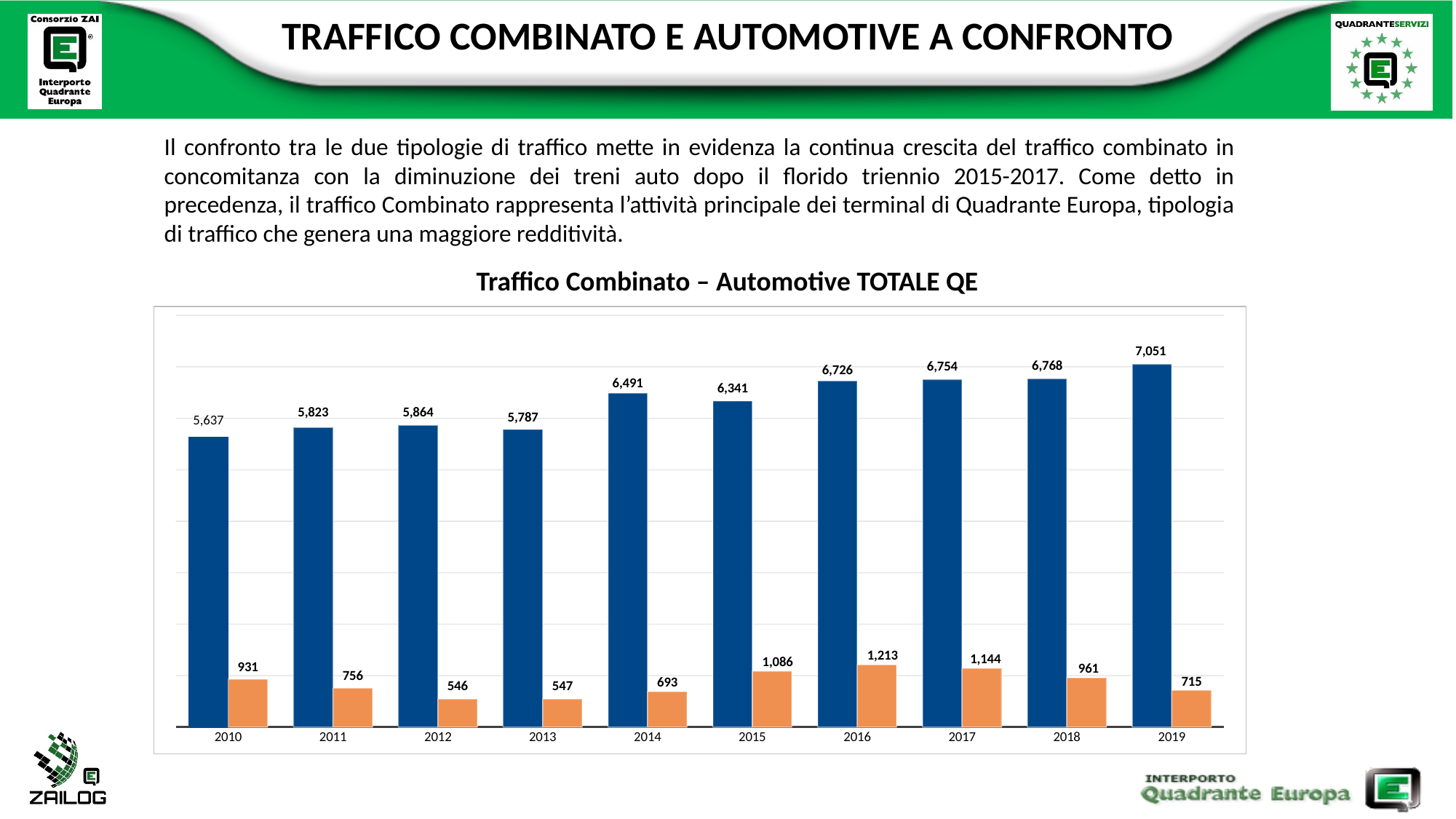
What is the value of the orange bar for 2016? 1,213 What is the difference between the blue bar values for 2019 and 2010? 1,414 Which year has the larger orange bar, 2015 or 2018? 2015 What kind of chart is shown on the slide? Bar chart What is the title of the chart? Traffico Combinato – Automotive TOTALE QE What is the value of the blue bar for 2019? 7,051 What is the difference between the orange bar values for 2016 and 2019? 498 How many years are shown on the x axis? 10 What is the value of the blue bar for 2013? 5,787 In which year is the blue bar lowest? 2010 In which year is the orange bar highest? 2016 In which year is the blue bar highest? 2019